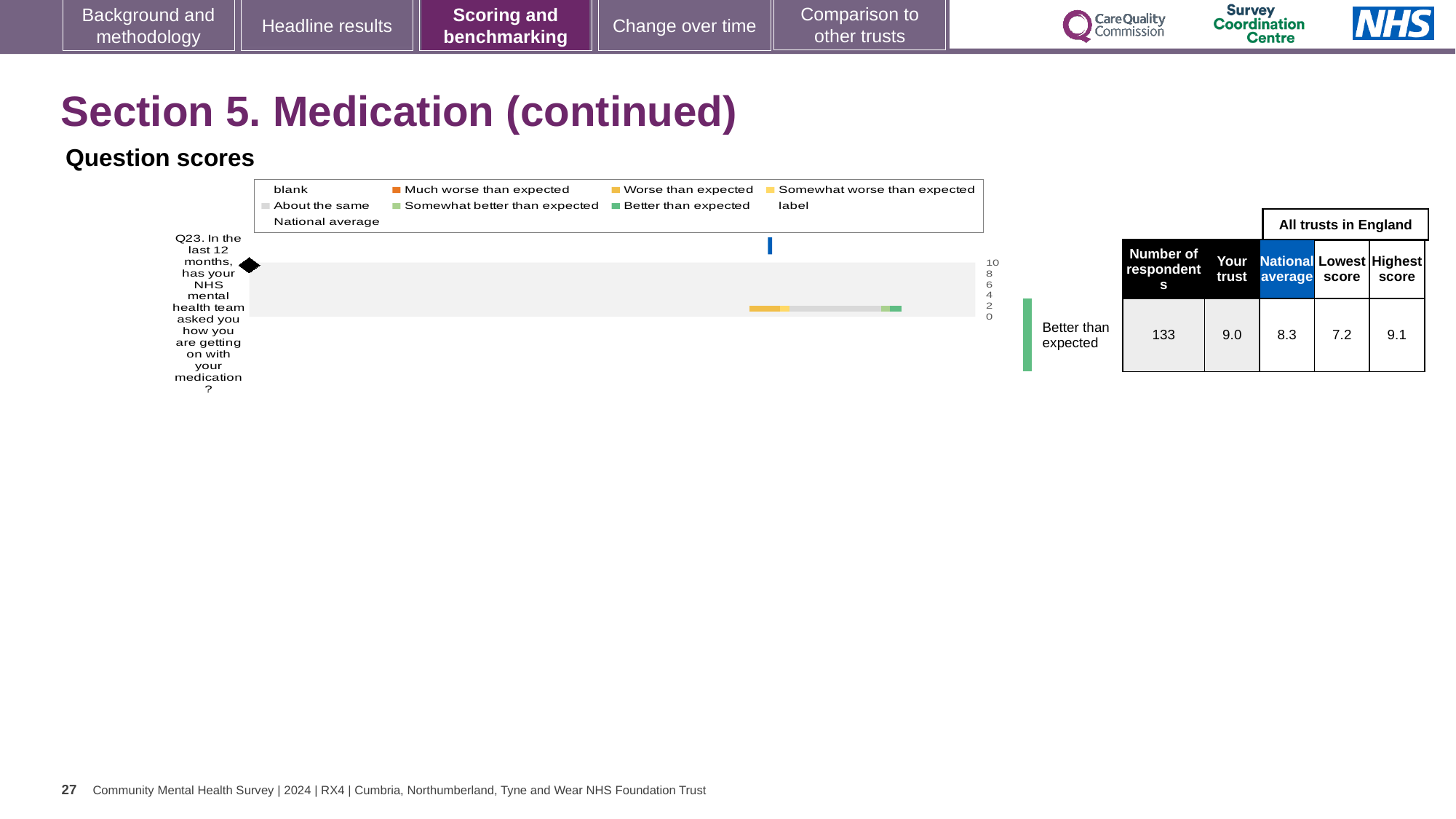
What is the lowest score among all trusts in England for Q23? 7.2 What is the difference between the highest and lowest scores for Q23? 1.9 What is the 'Your trust' score for Q23? 9.0 What benchmark category label is shown next to the Q23 bar? Better than expected What is the highest score among all trusts in England for Q23? 9.1 What is the difference between the 'Your trust' score and the national average for Q23? 0.7 How many survey questions are plotted in the Question scores chart? 1 Which is larger for Q23, the 'Your trust' score or the national average? Your trust What kind of chart is shown under 'Question scores'? bar chart What is the national average score for Q23? 8.3 How many respondents answered Q23? 133 Which question number is plotted in the Question scores chart? Q23